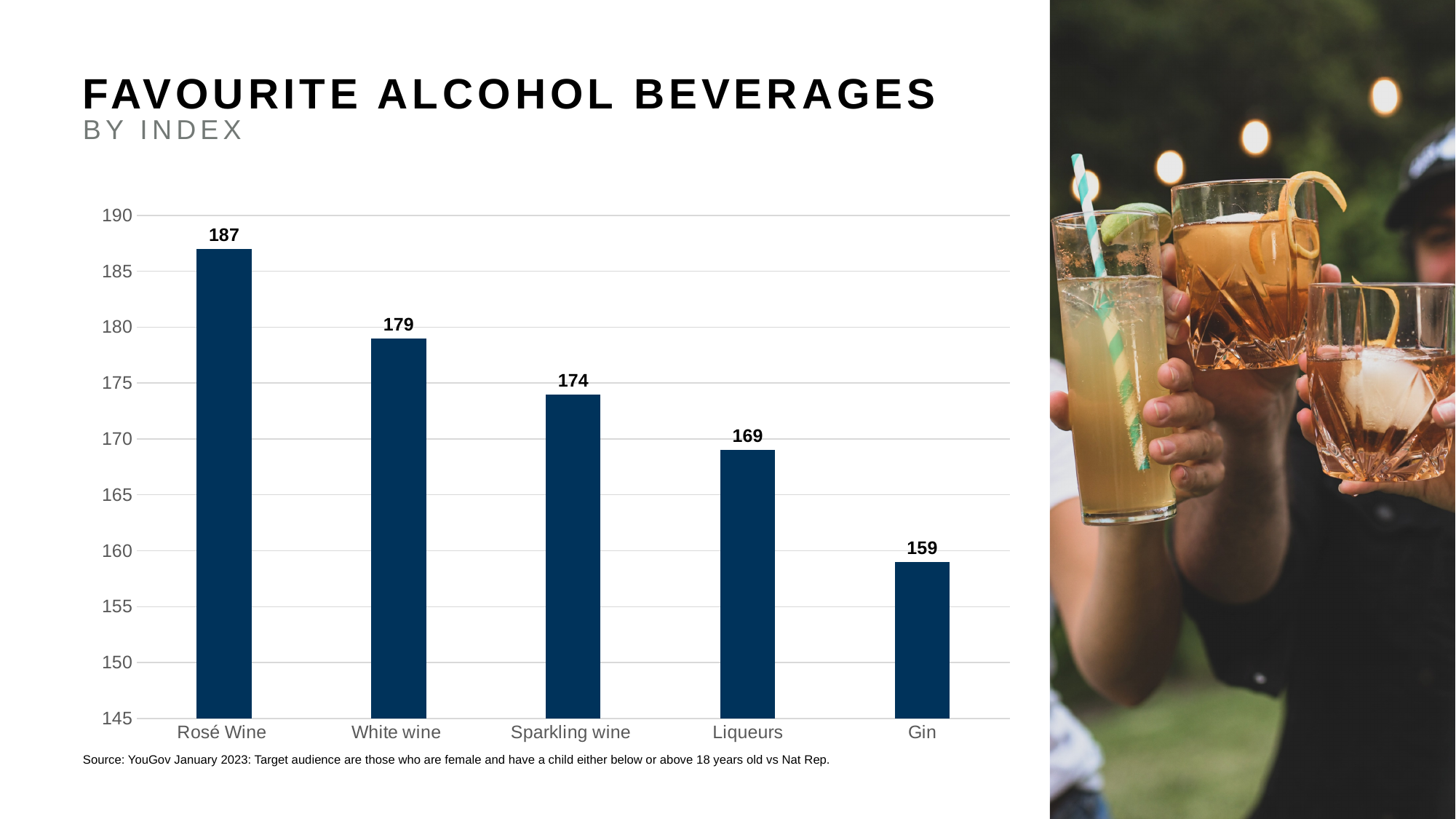
Do the index values rise or fall from left to right across the categories? fall Which beverage has the highest index? Rosé Wine Which has a higher index, White wine or Sparkling wine? White wine What is the index value for Rosé Wine? 187 What kind of chart is shown on the slide? bar chart Which beverage has the lowest index? Gin What is the difference between the index for Rosé Wine and the index for Gin? 28 Is the index for Liqueurs greater or less than 170? less What is the index value for Gin? 159 What is the index value for Sparkling wine? 174 What is the difference between the index for White wine and the index for Liqueurs? 10 How many beverage categories are shown in the chart? 5